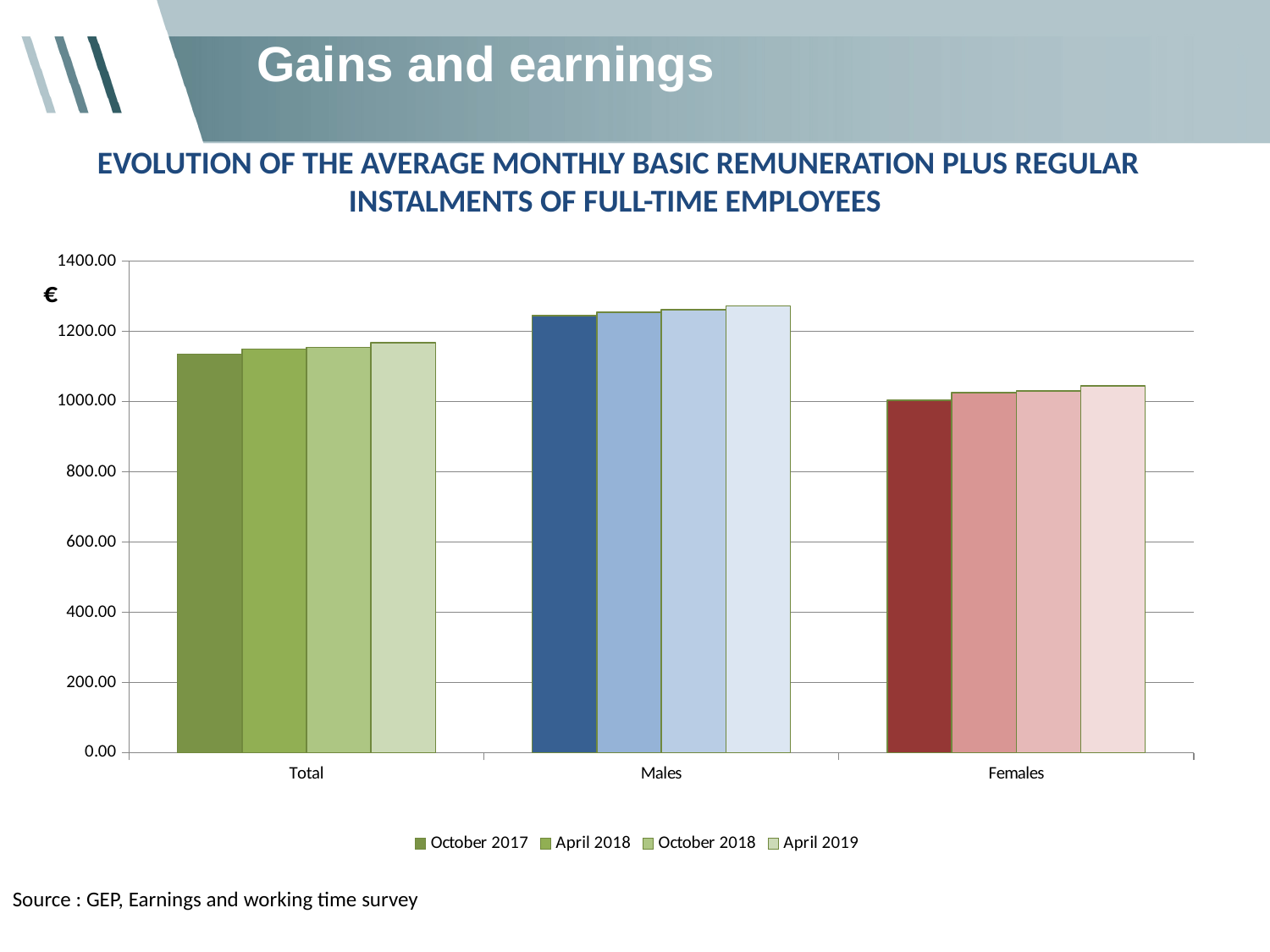
Is the value for Males in April 2019 greater or less than 1200? greater How many categories are shown on the x axis? 3 Is the value for Total in April 2019 greater or less than 1000? greater Which category has the highest values? Males How many series does the legend list? 4 Is the value for Total in October 2017 greater or less than 1200? less Within each category, do the values rise or fall from October 2017 to April 2019? rise What kind of chart is shown on the slide? bar chart Which category has the lowest values? Females What is the source cited below the chart? GEP, Earnings and working time survey Which is larger, the value for Males in October 2017 or the value for Females in April 2019? Males in October 2017